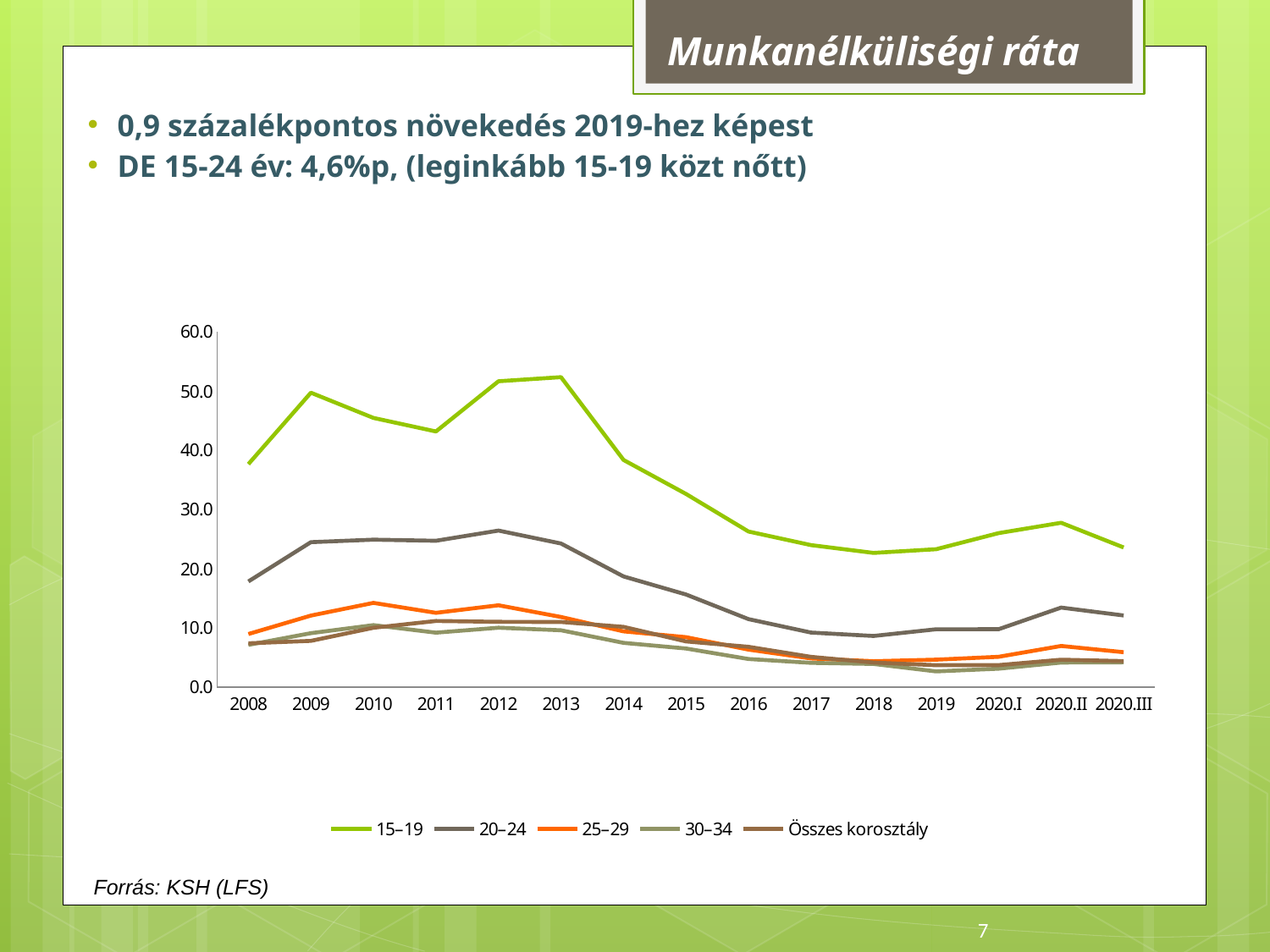
Is the value for the 15–19 series in 2008 greater or less than 40.0? less Which is larger for the 20–24 series: the value in 2008 or the value in 2012? 2012 How many points are there along the x axis? 15 Does the 15–19 series rise or fall from 2013 to 2018? fall Which is larger for the 15–19 series: the value in 2009 or the value in 2011? 2009 What is the title of the slide containing the chart? Munkanélküliségi ráta What kind of chart is shown on the slide? line chart Which series has the highest value in 2013? 15–19 Is the value for the 25–29 series in 2010 greater or less than 10.0? greater Is the value for the 15–19 series in 2013 greater or less than 50.0? greater How many series does the legend list? 5